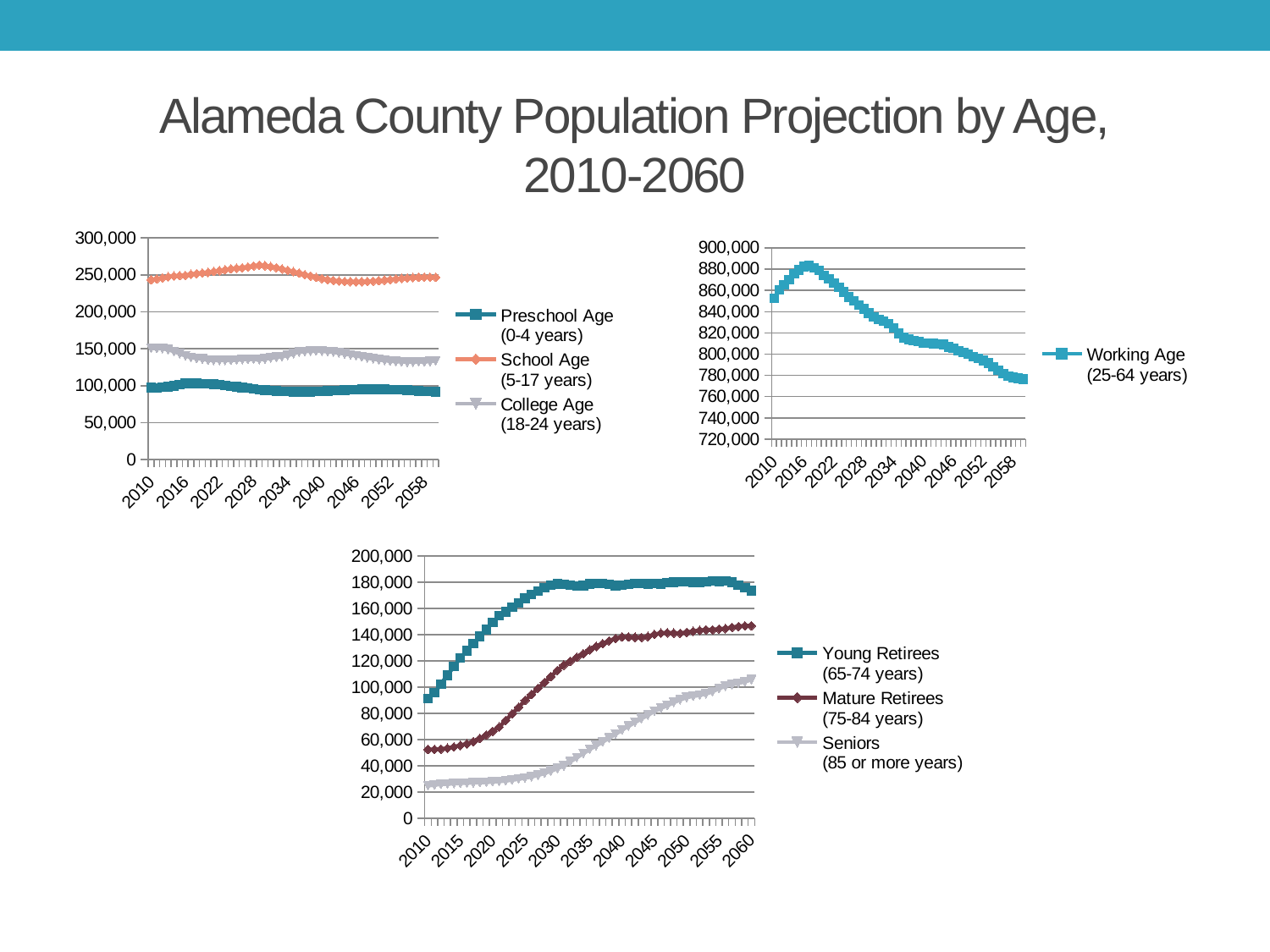
In the bottom chart, which series has the highest values in 2060? Young Retirees (65-74 years) In the top-left chart, which series has the lowest values across the whole period? Preschool Age (0-4 years) In the top-right chart, is the value for Working Age (25-64 years) in 2010 greater or less than 840,000? greater What kind of chart is the top-right chart? line chart In the top-left chart, which series has the highest values across the whole period? School Age (5-17 years) How many series does the legend of the top-left chart list? 3 In the top-right chart, is the value for Working Age (25-64 years) in 2058 greater or less than 800,000? less In the top-left chart, is the value for College Age (18-24 years) in 2010 greater or less than 100,000? greater In the top-right chart, does the Working Age (25-64 years) line end higher or lower in 2058 than it started in 2010? lower In the bottom chart, do the values for Mature Retirees (75-84 years) rise or fall from 2010 to 2060? rise